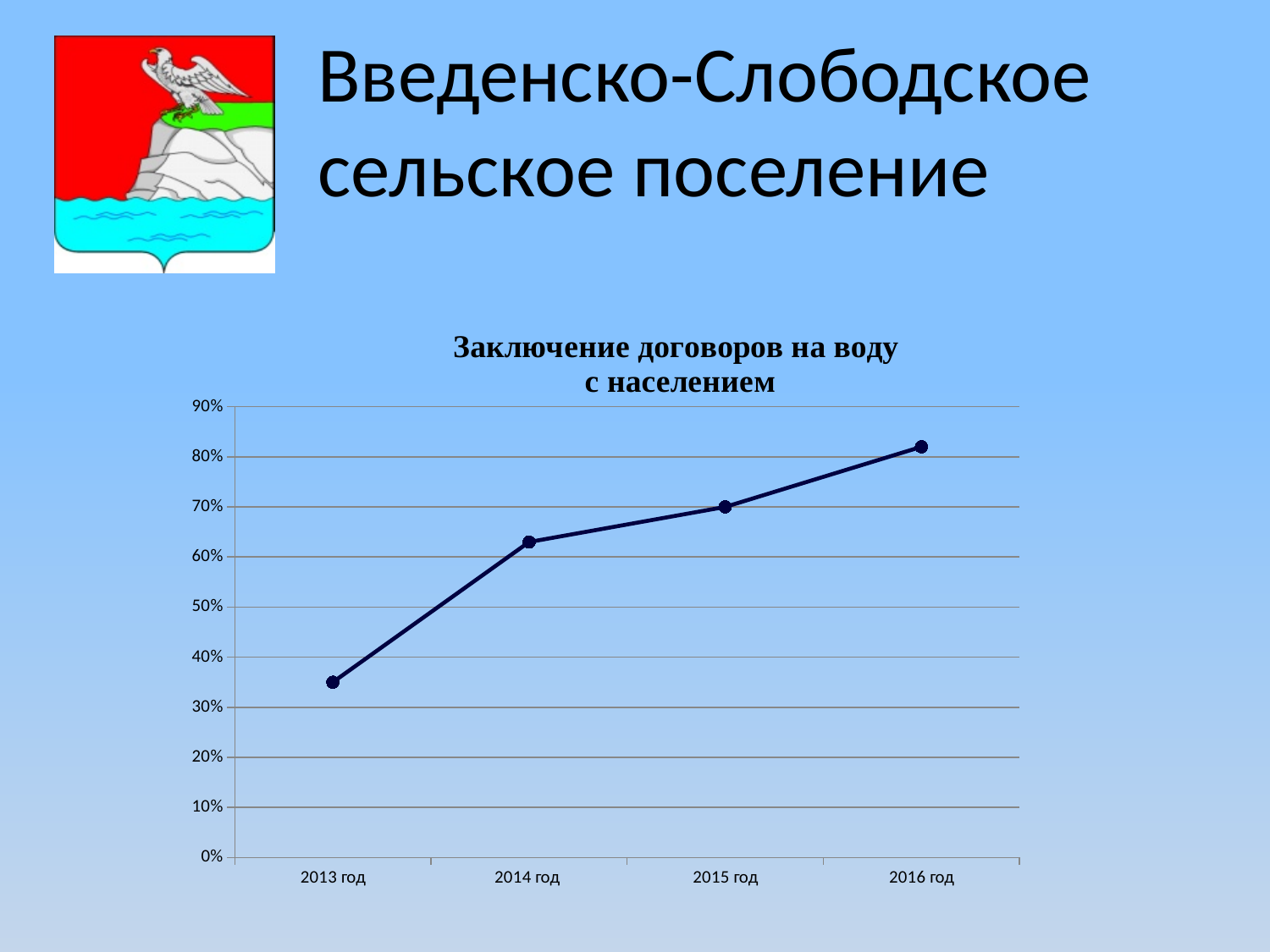
Which year has the highest value in the chart? 2016 год What is the title of the chart? Заключение договоров на воду с населением Is the value for 2013 год greater or less than 30%? greater How many years are plotted on the x axis of the chart? 4 Which is larger, the value for 2014 год or the value for 2016 год? 2016 год Is the value for 2016 год greater or less than 80%? greater What kind of chart is shown on the slide? line chart Is the value for 2013 год greater or less than 40%? less Do the values rise or fall from 2013 год to 2016 год? rise What is the value for 2015 год? 70% Which year has the lowest value in the chart? 2013 год